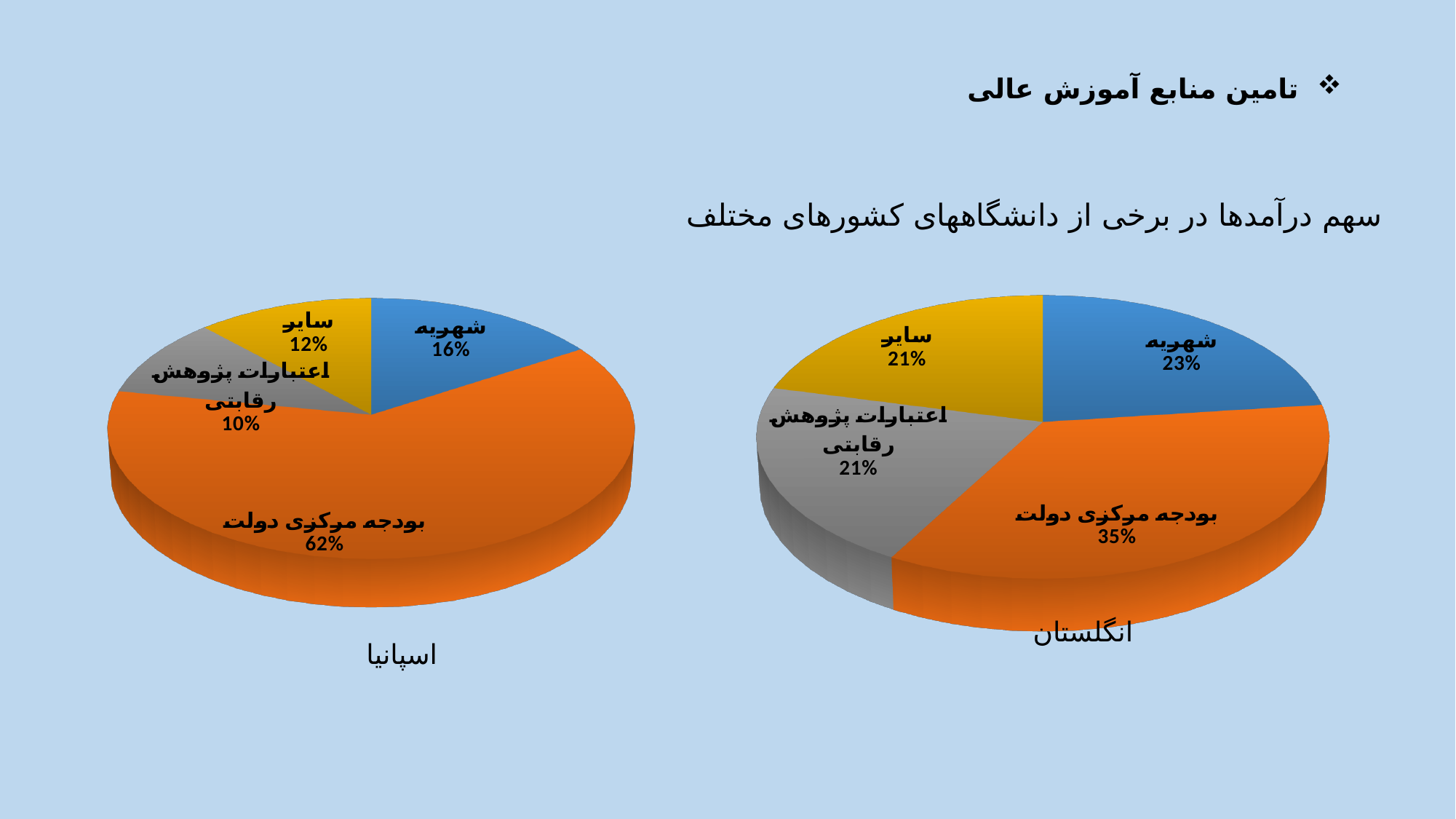
In the pie chart labelled انگلستان (right), what share is shown for شهریه? 23% In the pie chart labelled اسپانیا (left), what share is shown for شهریه? 16% In the pie chart labelled انگلستان (right), what share is shown for سایر? 21% In the pie chart labelled اسپانیا (left), what share is shown for بودجه مرکزی دولت? 62% How many slices does the pie chart labelled انگلستان (right) have? 4 In the pie chart labelled انگلستان (right), what share is shown for بودجه مرکزی دولت? 35% In the pie chart labelled اسپانیا (left), which category has the largest share? بودجه مرکزی دولت In the pie chart labelled انگلستان (right), which category has the largest share? بودجه مرکزی دولت In the pie chart labelled اسپانیا (left), which category has the smallest share? اعتبارات پژوهش رقابتی What is the difference between the share of بودجه مرکزی دولت in the اسپانیا chart and in the انگلستان chart? 27% What type of chart is used on this slide? Pie chart Which chart shows a larger share for شهریه, اسپانیا or انگلستان? انگلستان